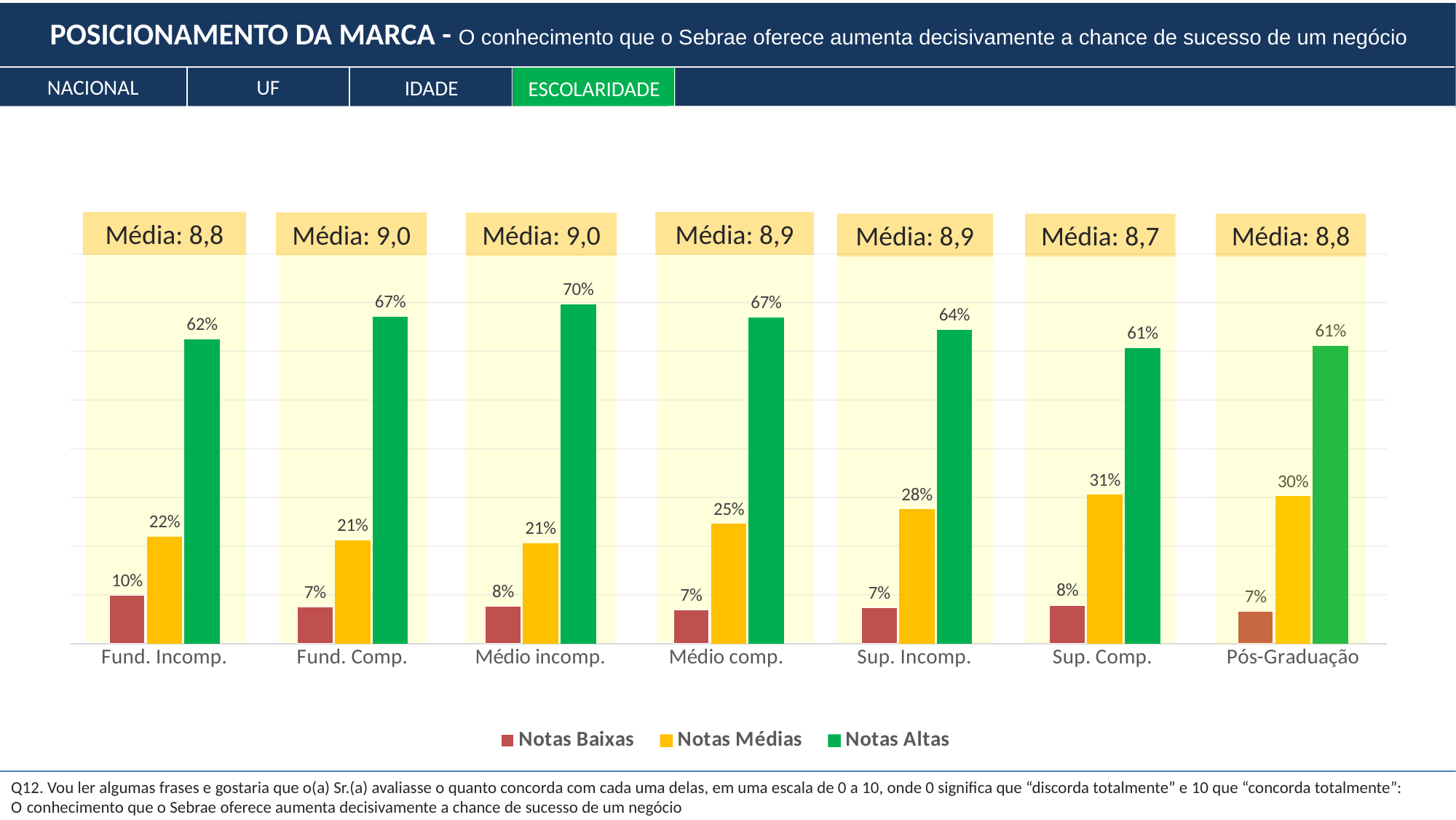
What is the difference between Notas Altas for Fund. Comp. and Notas Altas for Pós-Graduação? 6% How many series does the legend list? 3 What is the value of Notas Médias for Sup. Comp.? 31% What is the value of Notas Baixas for Fund. Incomp.? 10% How many education categories are shown on the x axis? 7 Which category has the lowest Notas Médias value? Fund. Comp. and Médio incomp. (21%) What is the Média shown above the Sup. Comp. category? 8,7 Which tab is highlighted in green at the top of the slide? ESCOLARIDADE Which is larger: Notas Médias for Sup. Incomp. or Notas Médias for Médio comp.? Sup. Incomp. What is the value of Notas Altas for Médio incomp.? 70% Which category has the highest Notas Altas value? Médio incomp. What kind of chart is shown on the slide? Bar chart